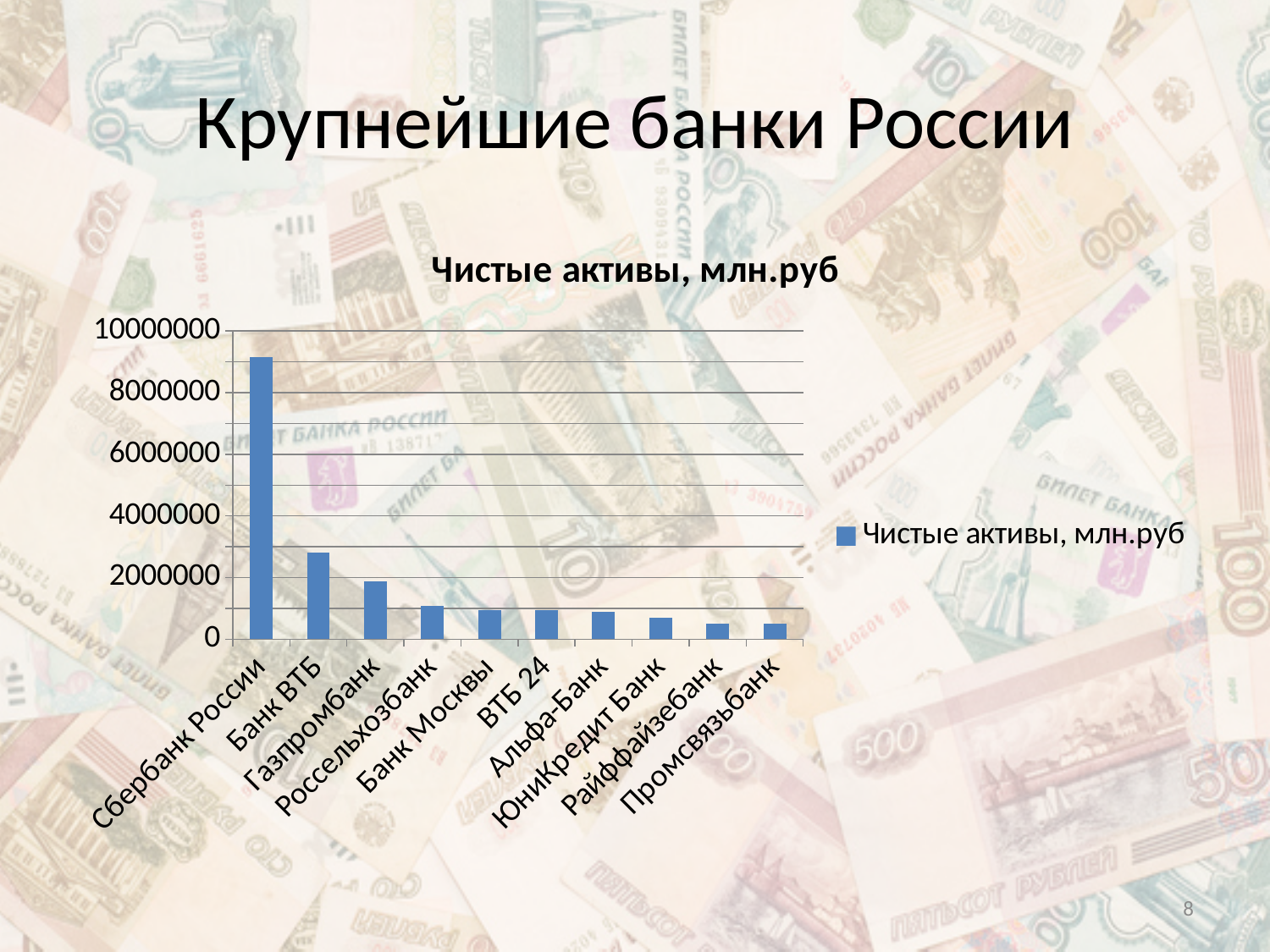
How many banks are shown on the x axis of the chart? 10 Is the value for Промсвязьбанк greater or less than 2000000? less Is the value for Банк ВТБ greater or less than 2000000? greater How many series does the legend list? 1 What is the title of the chart? Чистые активы, млн.руб Which bank has the highest net assets in the chart? Сбербанк России Which is larger, the value for Сбербанк России or the value for Банк ВТБ? Сбербанк России Which is larger, the value for Газпромбанк or the value for Россельхозбанк? Газпромбанк Do the values generally rise or fall from left to right along the x axis? fall Is the value for Газпромбанк greater or less than 2000000? less What kind of chart is shown on the slide? bar chart